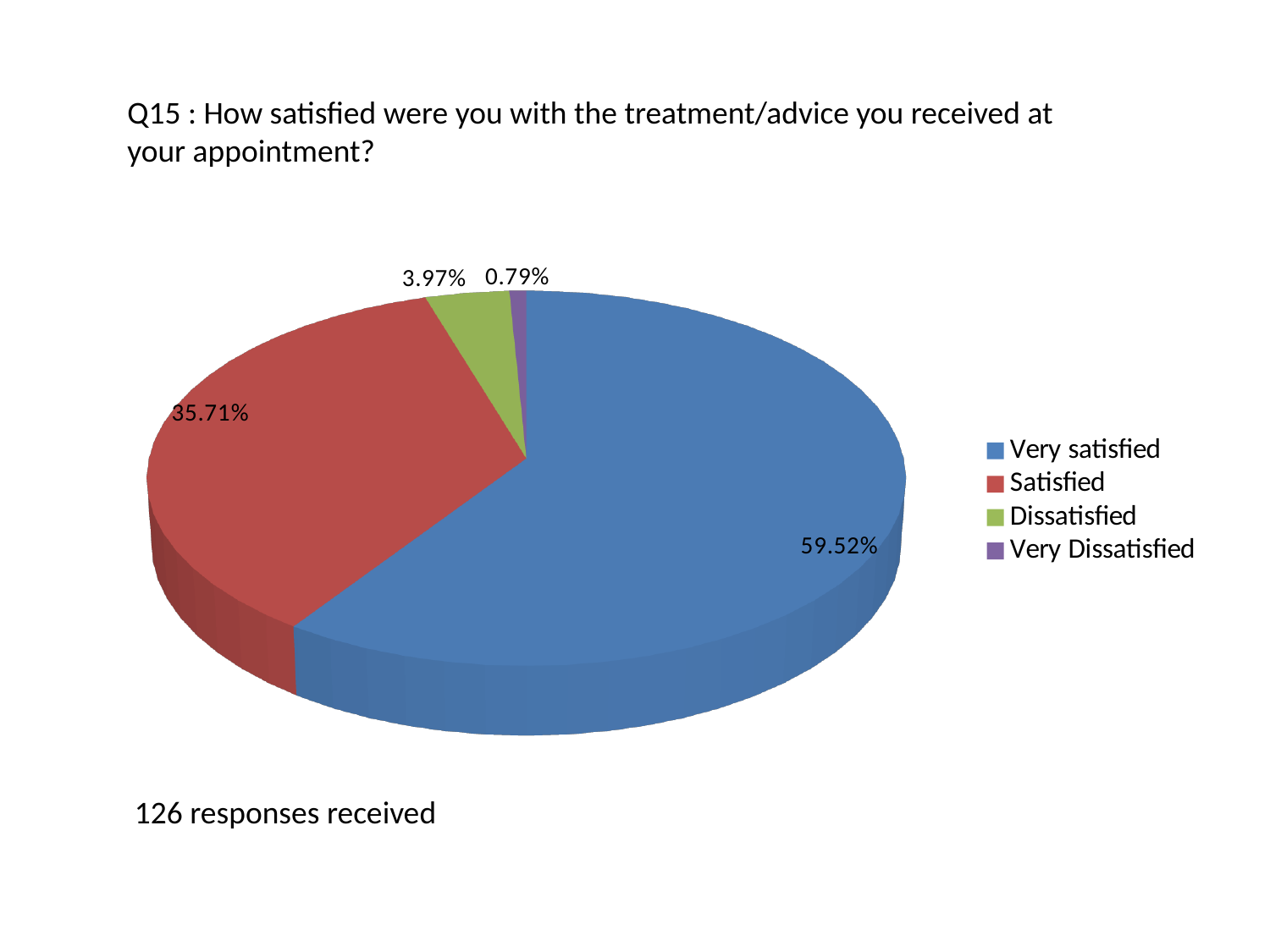
What percentage of respondents were Very Dissatisfied? 0.79% How many responses were received according to the slide? 126 What percentage of respondents were Satisfied? 35.71% Which is larger, the share for Dissatisfied or the share for Very Dissatisfied? Dissatisfied What kind of chart is shown on the slide? pie chart What colour is the Satisfied slice? red What percentage of respondents were Dissatisfied? 3.97% What is the difference in percentage points between Very satisfied and Satisfied? 23.81 What percentage of respondents were Very satisfied? 59.52% How many categories does the pie chart show? 4 Which category has the smallest share of the pie? Very Dissatisfied Which category has the largest share of the pie? Very satisfied